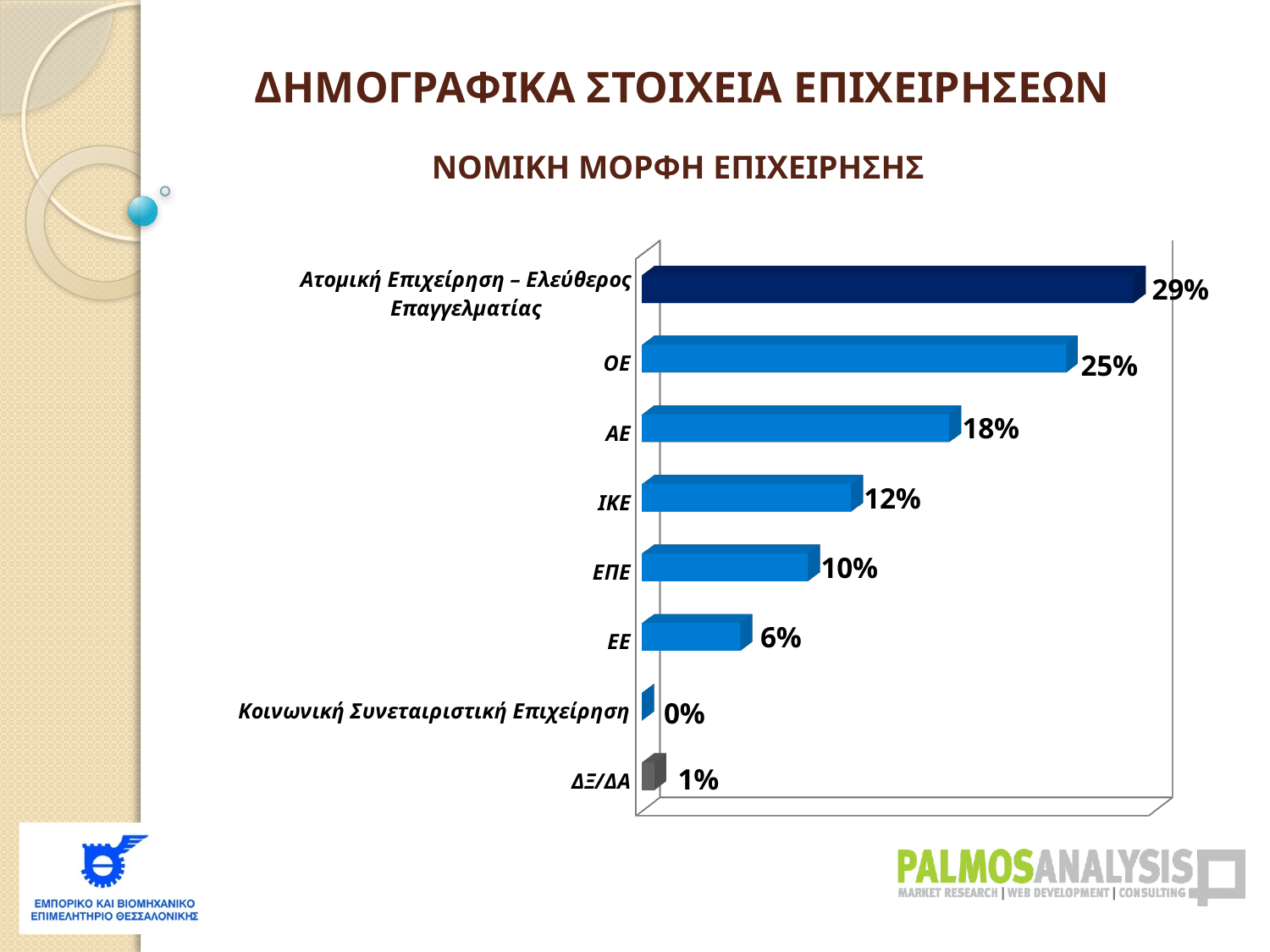
What kind of chart is shown on the slide? Bar chart What is the difference between the values for ΟΕ and ΑΕ? 7% What is the title of the chart? ΝΟΜΙΚΗ ΜΟΡΦΗ ΕΠΙΧΕΙΡΗΣΗΣ Which category has the lowest value? Κοινωνική Συνεταιριστική Επιχείρηση Which category has the highest value? Ατομική Επιχείρηση – Ελεύθερος Επαγγελματίας Which is larger, the value for ΕΠΕ or the value for ΕΕ? ΕΠΕ What is the value for ΙΚΕ? 12% What is the value for ΔΞ/ΔΑ? 1% What is the value for Ατομική Επιχείρηση – Ελεύθερος Επαγγελματίας? 29% What is the difference between the values for ΙΚΕ and ΕΠΕ? 2% How many categories are shown in the chart? 8 What is the value for ΟΕ? 25%